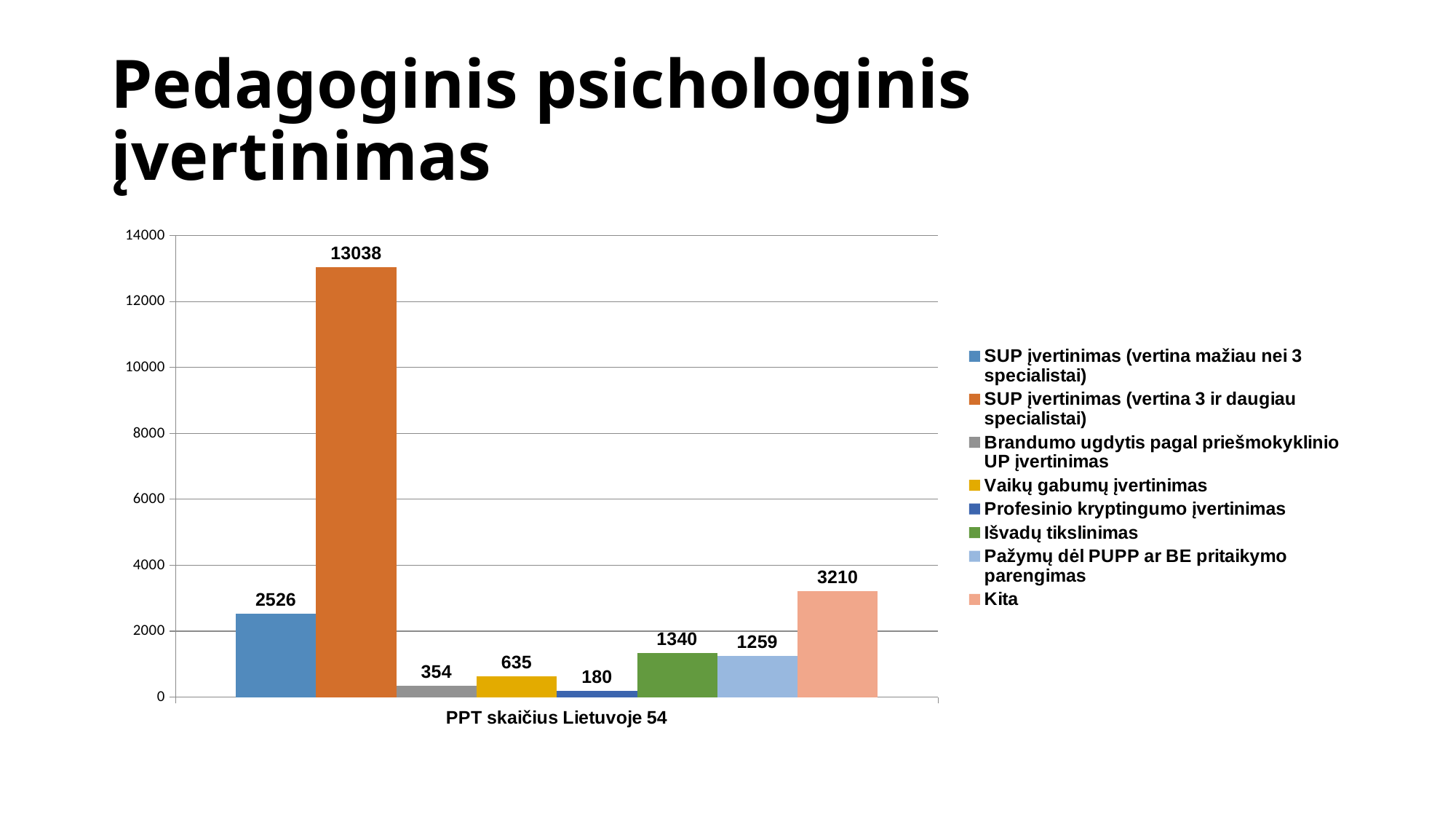
What is the value for 'Kita'? 3210 Which is larger: 'Išvadų tikslinimas' or 'Pažymų dėl PUPP ar BE pritaikymo parengimas'? Išvadų tikslinimas What kind of chart is shown on the slide? bar chart What is the value for 'Profesinio kryptingumo įvertinimas'? 180 What is the value for 'SUP įvertinimas (vertina 3 ir daugiau specialistai)'? 13038 Which series has the highest value? SUP įvertinimas (vertina 3 ir daugiau specialistai) What is the difference between 'SUP įvertinimas (vertina 3 ir daugiau specialistai)' and 'SUP įvertinimas (vertina mažiau nei 3 specialistai)'? 10512 What is the label shown on the x axis below the bars? PPT skaičius Lietuvoje 54 Which series has the lowest value? Profesinio kryptingumo įvertinimas How many series does the legend list? 8 What is the value for 'Išvadų tikslinimas'? 1340 Is the value for 'Kita' greater or less than 4000? less